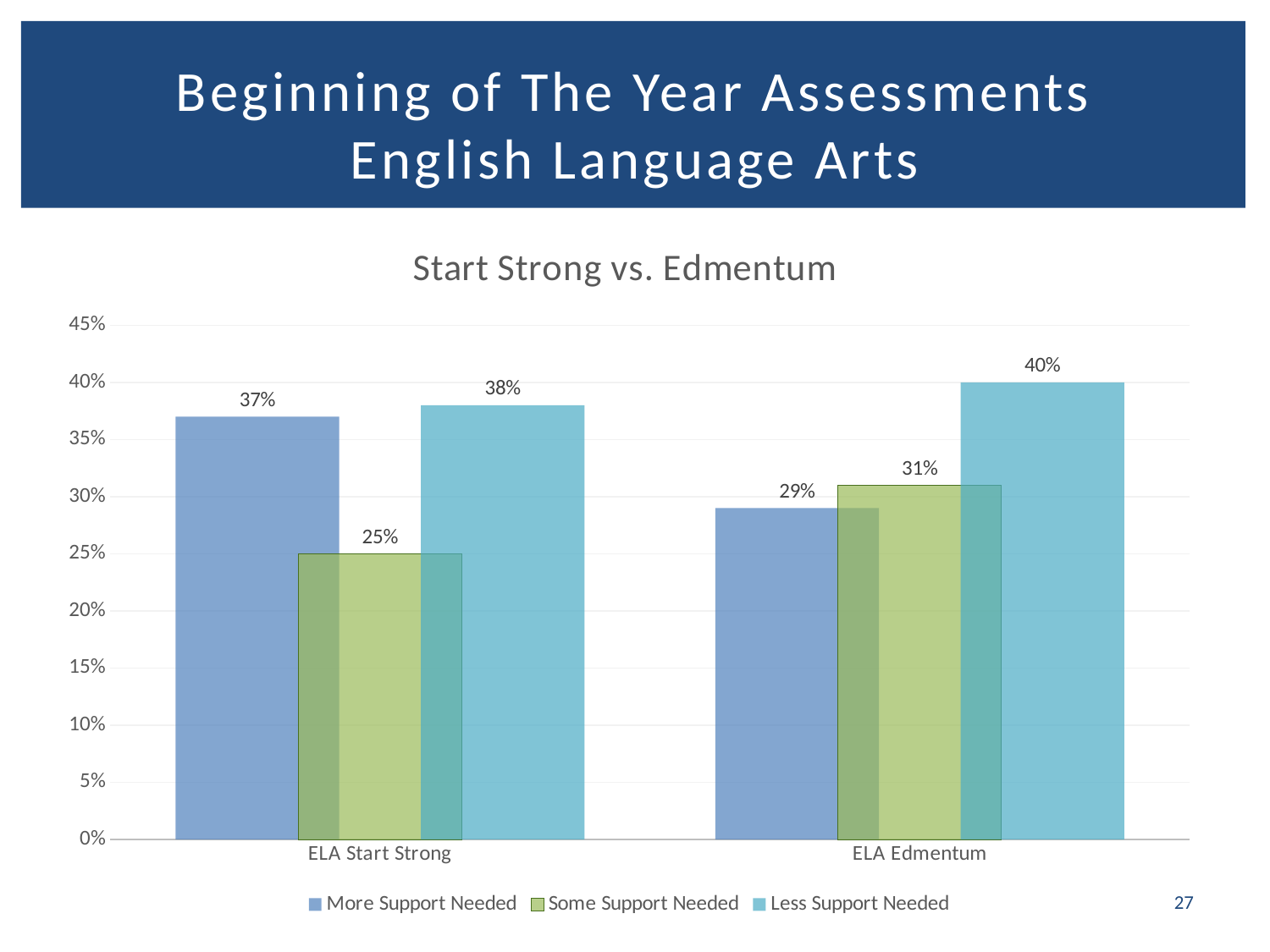
What kind of chart is shown on the slide? Bar chart What is the value for More Support Needed in the ELA Edmentum category? 29% Which series has the highest value in the ELA Edmentum category? Less Support Needed How many series does the legend list? 3 Which series has the lowest value in the ELA Start Strong category? Some Support Needed Which is larger: More Support Needed for ELA Start Strong or More Support Needed for ELA Edmentum? ELA Start Strong How many categories are shown on the x axis? 2 What is the value for More Support Needed in the ELA Start Strong category? 37% What is the title of the chart? Start Strong vs. Edmentum What is the value for Less Support Needed in the ELA Start Strong category? 38% What is the difference between Less Support Needed and Some Support Needed in the ELA Start Strong category? 13% What is the value for Some Support Needed in the ELA Edmentum category? 31%